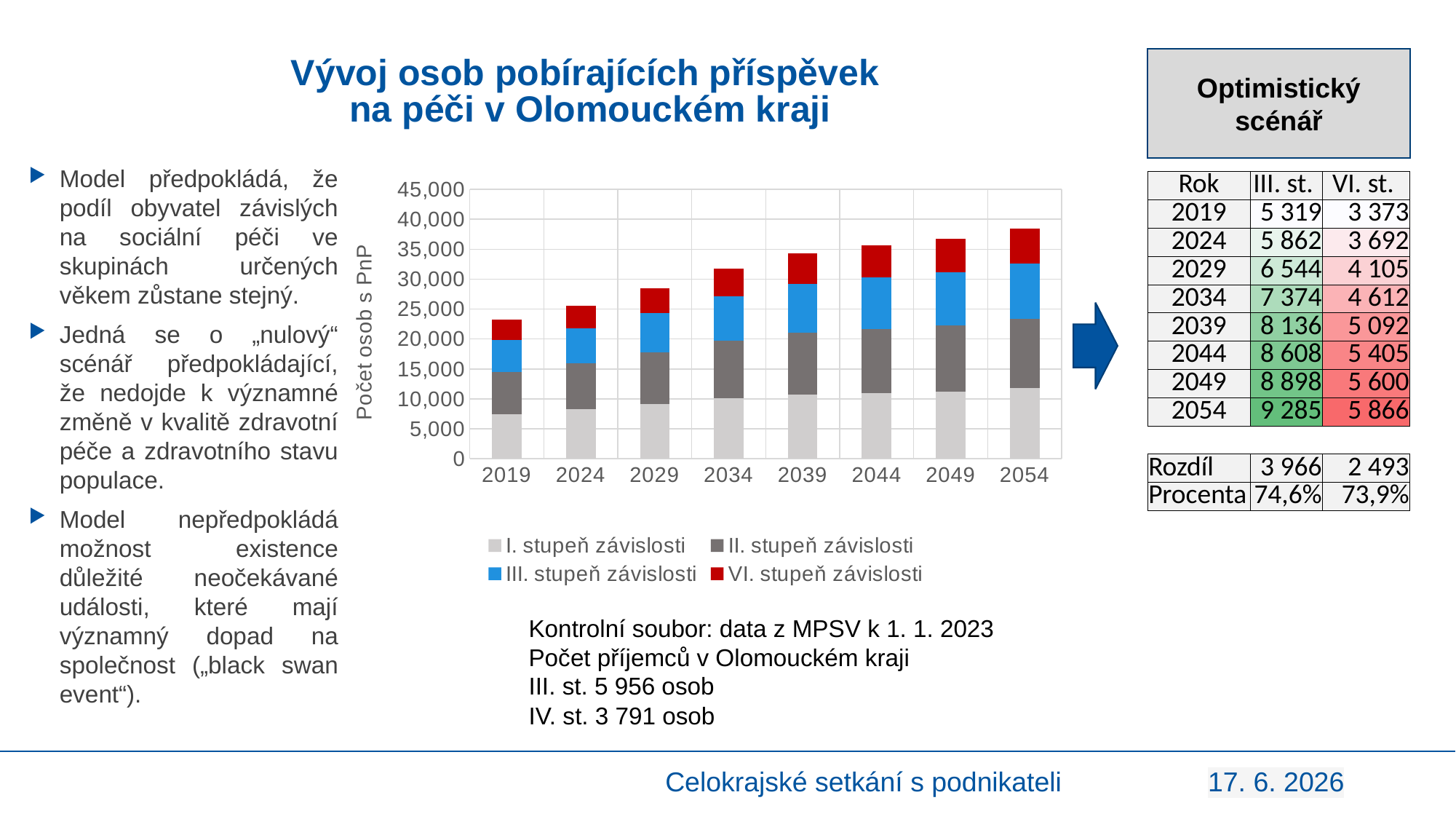
Which total stacked bar is larger, 2029 or 2049? 2049 How many years (categories) are shown on the x axis of the chart? 8 What kind of chart is shown on the slide? Stacked bar chart Which year has the highest total stacked bar in the chart? 2054 Is the total stacked bar for 2054 greater or less than 35,000? greater Is the total stacked bar for 2034 greater or less than 30,000? greater How many series does the chart legend list? 4 Which year has the lowest total stacked bar in the chart? 2019 Is the total stacked bar for 2019 greater or less than 25,000? less Which series is shown in red in the chart legend? VI. stupeň závislosti What is the title of the chart's vertical axis? Počet osob s PnP Do the total stacked bar values rise or fall from 2019 to 2054? Rise